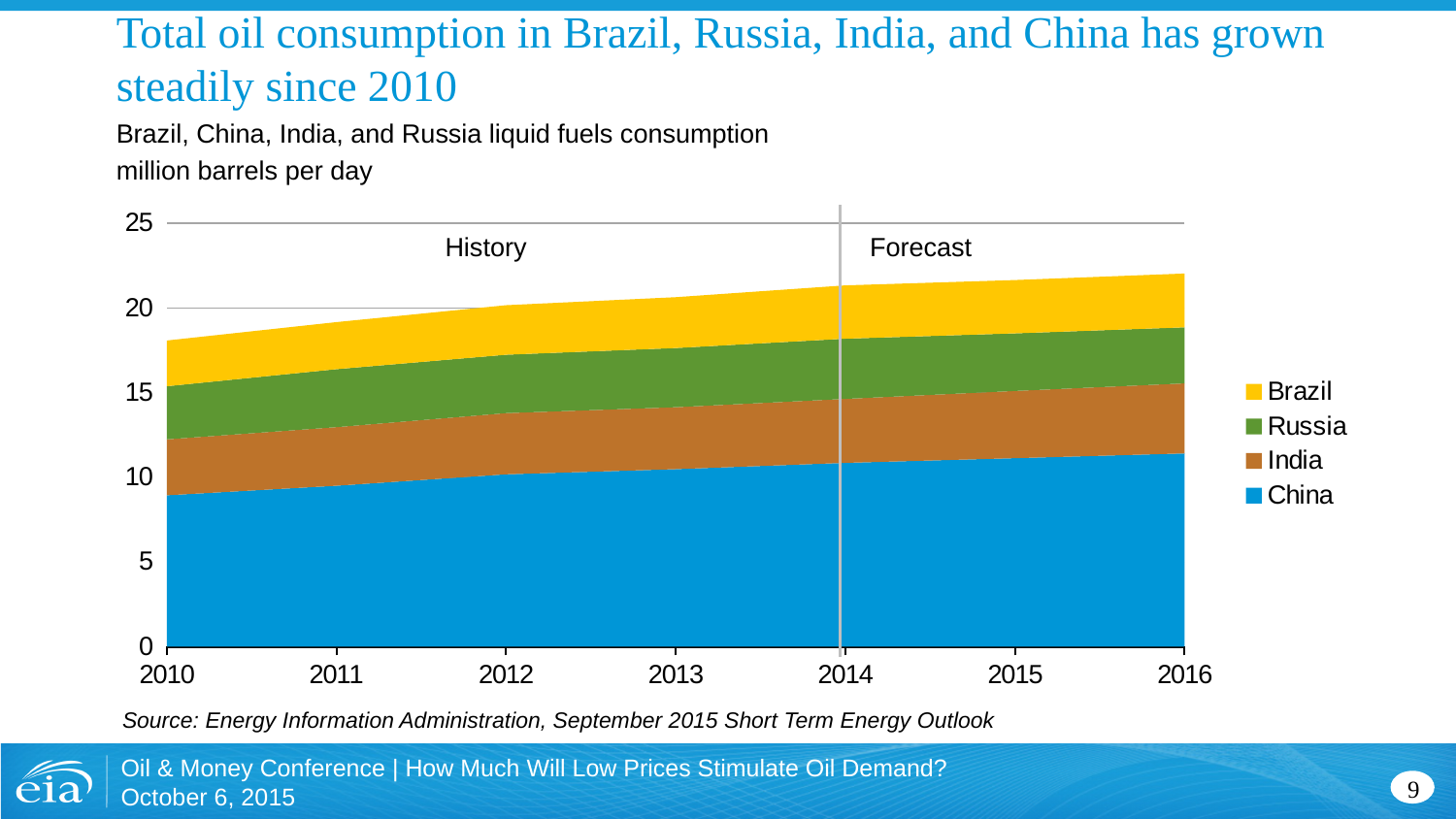
Is China's consumption in 2016 greater or less than 10 million barrels per day? greater Which country accounts for the largest share of consumption in every year shown? China What kind of chart is shown on the slide? Stacked area chart At which year does the vertical line separating History from Forecast appear? 2014 What unit is the y axis measured in? million barrels per day How many series does the legend list? 4 In 2016, which is larger: China's consumption or Brazil's consumption? China Is China's consumption in 2010 greater or less than 10 million barrels per day? less How many years are labelled along the x axis? 7 Is the total consumption for all four countries in 2016 greater or less than 20 million barrels per day? greater Does total liquid fuels consumption rise or fall from 2010 to 2016? Rises